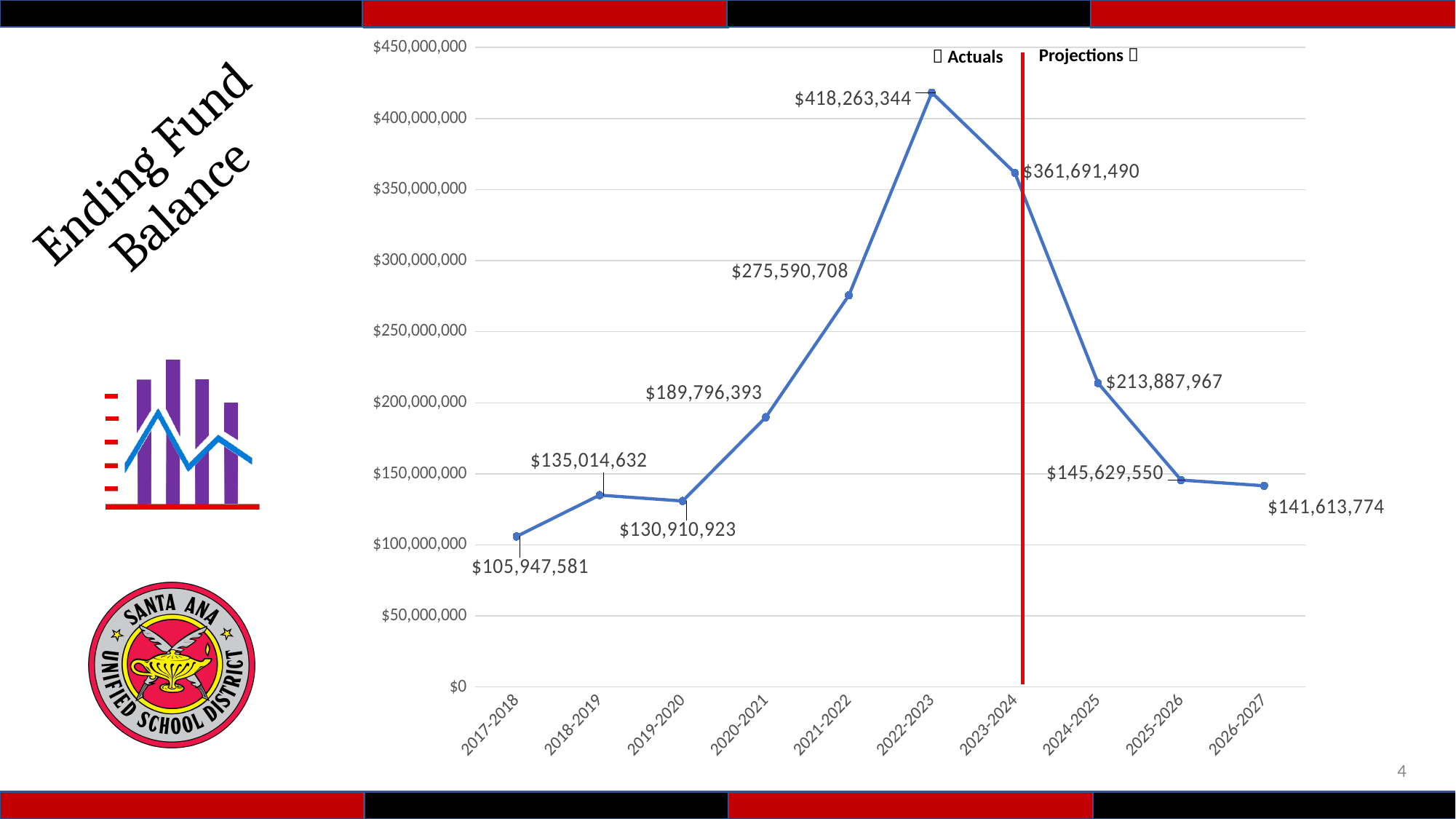
Does the ending fund balance rise or fall from 2022-2023 to 2026-2027? Fall Which is larger, the ending fund balance for 2021-2022 or for 2024-2025? 2021-2022 Which year has the lowest ending fund balance? 2017-2018 What kind of chart is shown on the slide? Line chart How many years are plotted on the chart? 10 What is the ending fund balance for 2017-2018? $105,947,581 What is the difference between the ending fund balance for 2018-2019 and 2019-2020? $4,103,709 What is the ending fund balance for 2022-2023? $418,263,344 Which year has the highest ending fund balance? 2022-2023 What is the difference between the ending fund balance for 2022-2023 and 2023-2024? $56,571,854 What is the projected ending fund balance for 2026-2027? $141,613,774 What is the ending fund balance for 2020-2021? $189,796,393